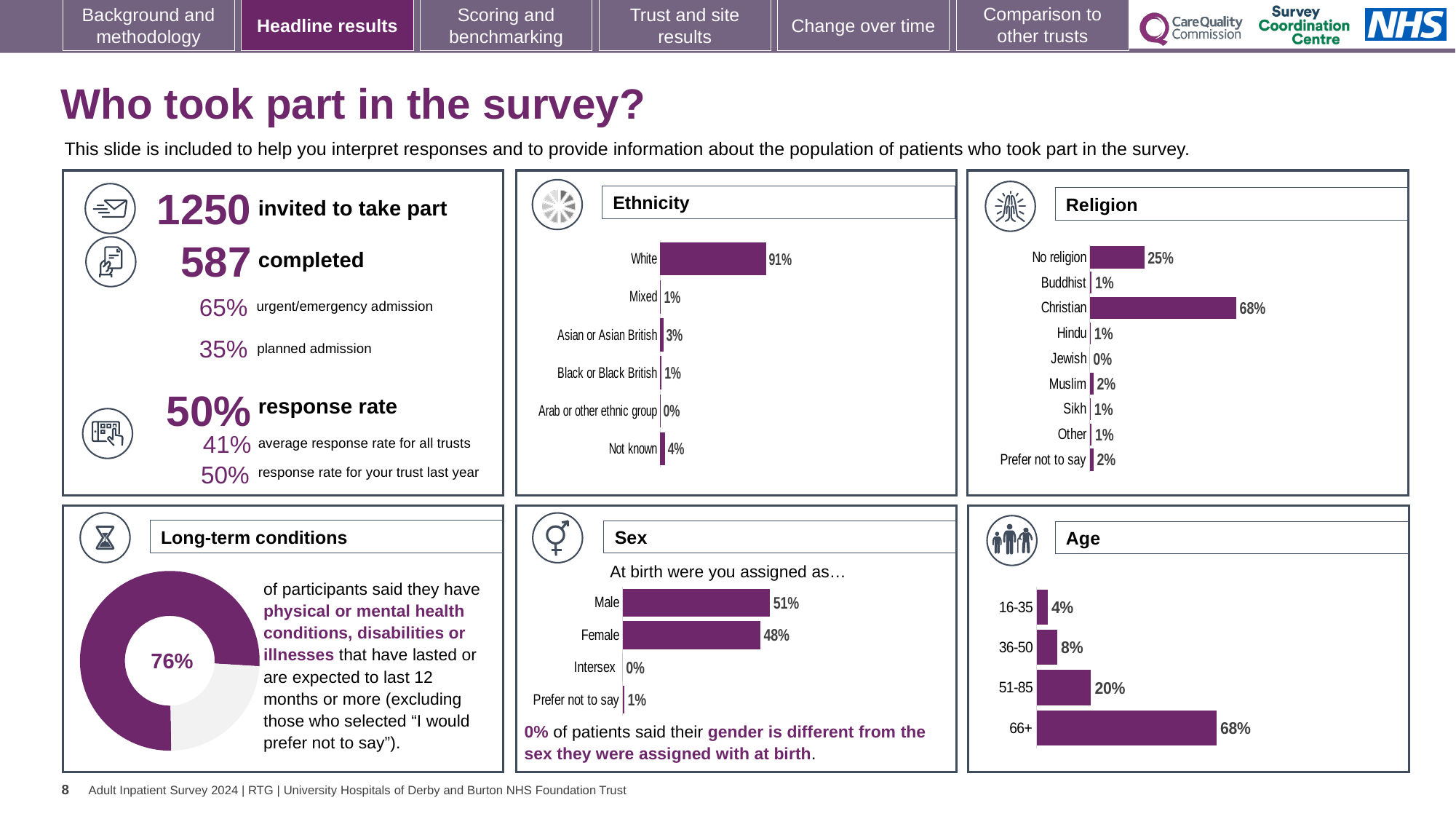
In the Age chart, what percentage of respondents were aged 66+? 68% In the Religion chart, what is the difference between the Christian and No religion values? 43% In the Religion chart, what percentage of respondents were Christian? 68% In the Sex chart, what percentage of respondents selected Prefer not to say? 1% In the Age chart, what is the difference between the 51-85 and 36-50 values? 12% In the Sex chart, which is larger, Male or Female? Male In the Ethnicity chart, which category has the highest value? White In the Ethnicity chart, how many categories are shown? 6 What kind of chart is used in the Long-term conditions panel? doughnut chart In the Age chart, do the values rise or fall as age increases from 16-35 to 66+? rise In the Religion chart, how many categories are shown? 9 In the Ethnicity chart, what percentage of respondents were White? 91%